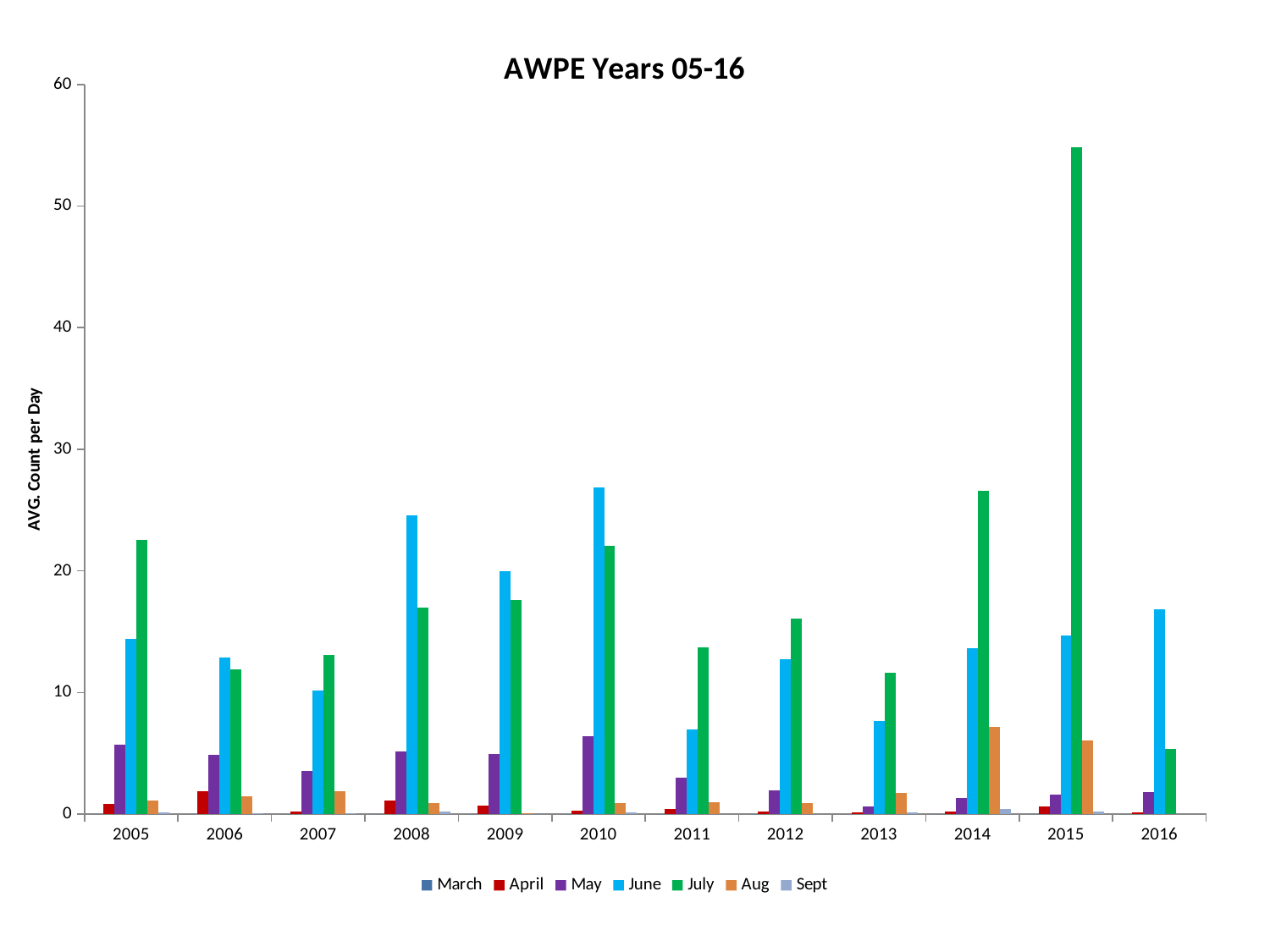
What is the title of the chart? AWPE Years 05-16 What is the label on the vertical axis? AVG. Count per Day In which year is the June bar the highest? 2010 In 2008, which is larger, the June bar or the July bar? June In which year is the July bar the highest? 2015 What kind of chart is shown on the slide? bar chart Is the value for July in 2013 greater or less than 20? less Is the value for June in 2010 greater or less than 20? greater How many years are shown along the x axis? 12 Which month has the tallest bar in 2016? June Is the value for July in 2015 greater or less than 50? greater How many series does the legend list? 7